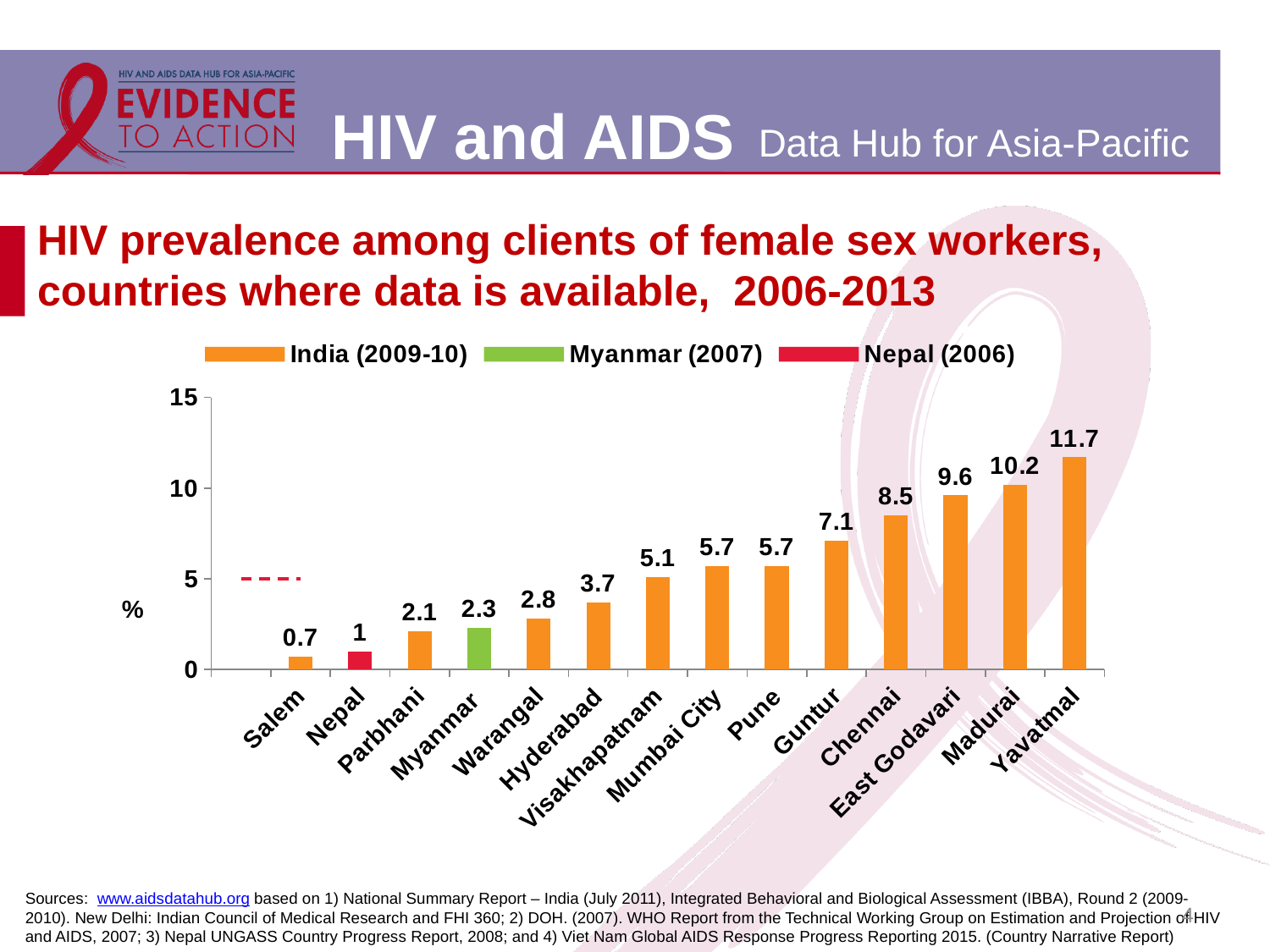
How many categories are plotted along the x axis? 14 Which category has the highest value in the chart? Yavatmal Which has a larger value, Guntur or Visakhapatnam? Guntur What is the value shown for Nepal? 1 What kind of chart is shown on the slide? Bar chart What is the value shown for Hyderabad? 3.7 What is the HIV prevalence value shown for Yavatmal? 11.7 What is the value shown for Myanmar? 2.3 What is the difference between the values for Madurai and Chennai? 1.7 Which category has the lowest value in the chart? Salem Which legend entry is shown in green? Myanmar (2007) How many series does the legend list? 3